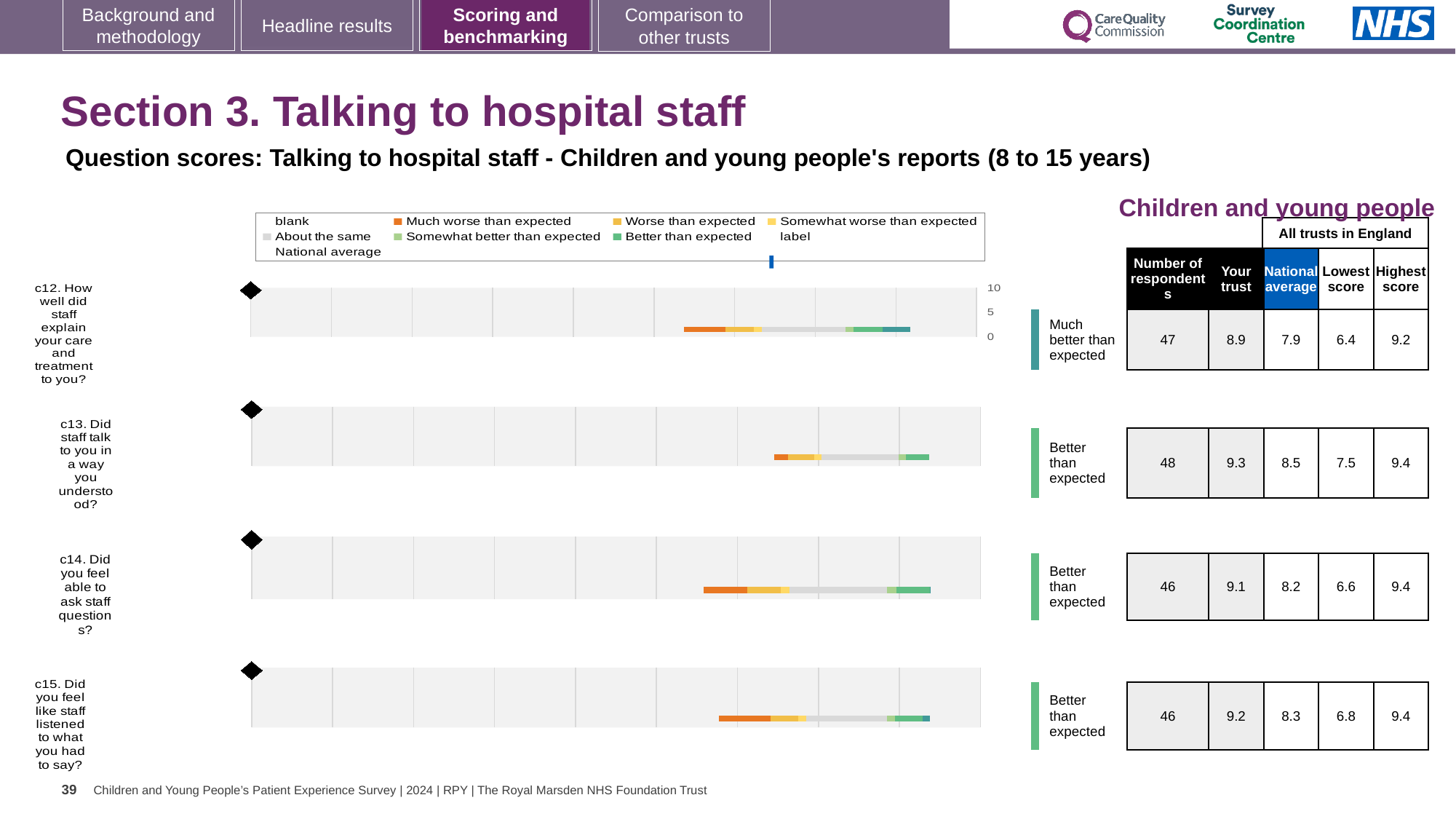
How many respondents answered c14 (Did you feel able to ask staff questions?)? 46 For c12, how much higher is the 'Your trust' score than the national average? 1.0 What kind of chart is used to show the question scores for c12 to c15? bar chart What colour represents 'Much worse than expected' in the legend? orange Which question has the lowest 'Lowest score' across all trusts in England? c12 How many survey questions (c12 to c15) are plotted on the slide? 4 What is the national average score for c13 (Did staff talk to you in a way you understood?)? 8.5 What is the 'Your trust' score for c12 (How well did staff explain your care and treatment to you?)? 8.9 What is the highest score across all trusts in England for c15 (Did you feel like staff listened to what you had to say?)? 9.4 Which question has the highest 'Your trust' score? c13 What benchmark category is shown for c12 (How well did staff explain your care and treatment to you?)? Much better than expected Which has the larger 'Your trust' score, c14 or c15? c15